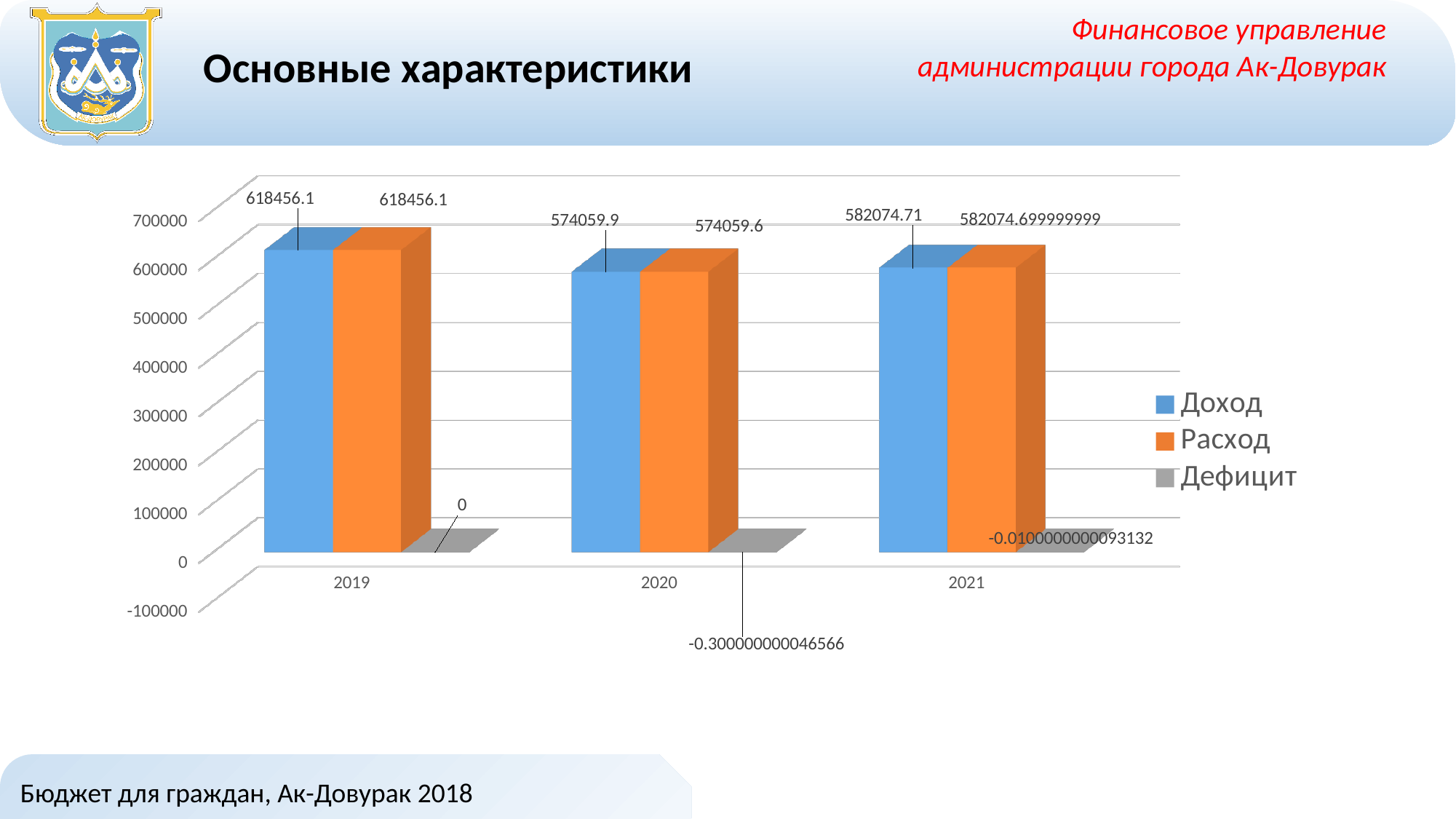
Which year has the highest Доход value? 2019 How many series does the legend list? 3 What is the difference between Доход in 2019 and Доход in 2020? 44396.2 What is the value of Доход for 2021? 582074.71 What is the value of Дефицит for 2020? -0.300000000046566 How many years are shown on the x axis? 3 What is the value of Расход for 2020? 574059.6 What is the value of Доход for 2019? 618456.1 Is the Доход value for 2020 greater or less than 600000? less What kind of chart is shown on the slide? bar chart What is the value of Дефицит for 2019? 0 Which year has the lowest Расход value? 2020